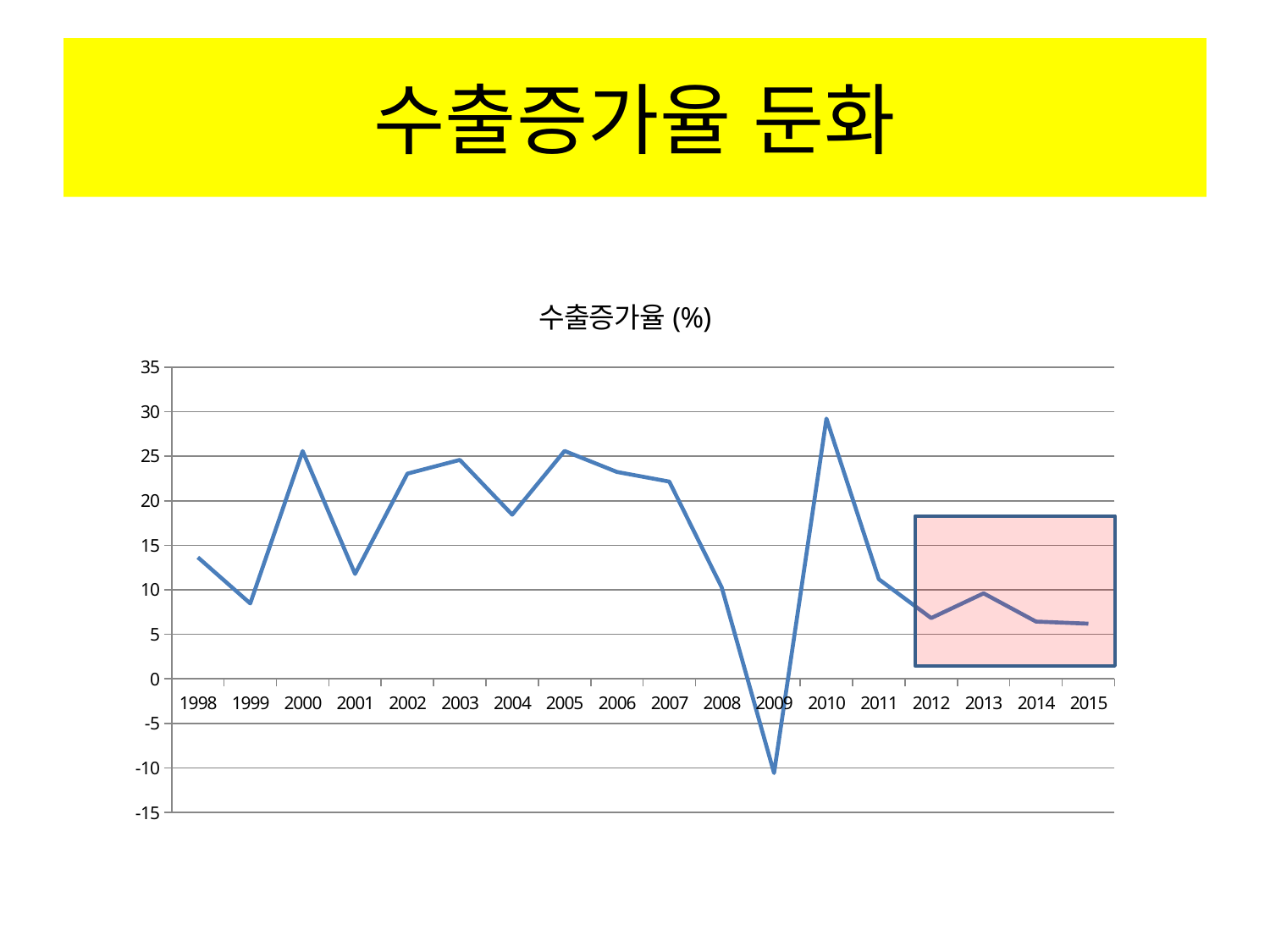
Is the value for 2000 greater or less than 20? greater Is the value for 2009 greater or less than 0? less What is the title of the chart? 수출증가율 (%) Which year has the highest export growth rate in the chart? 2010 Do the values generally rise or fall from 2010 to 2015? fall Which year has the larger value, 2001 or 2004? 2004 Which year has the lowest export growth rate in the chart? 2009 What kind of chart is shown on the slide? line chart How many years are plotted on the x axis of the chart? 18 Is the value for 2015 greater or less than 10? less Which year has the larger value, 2012 or 2013? 2013